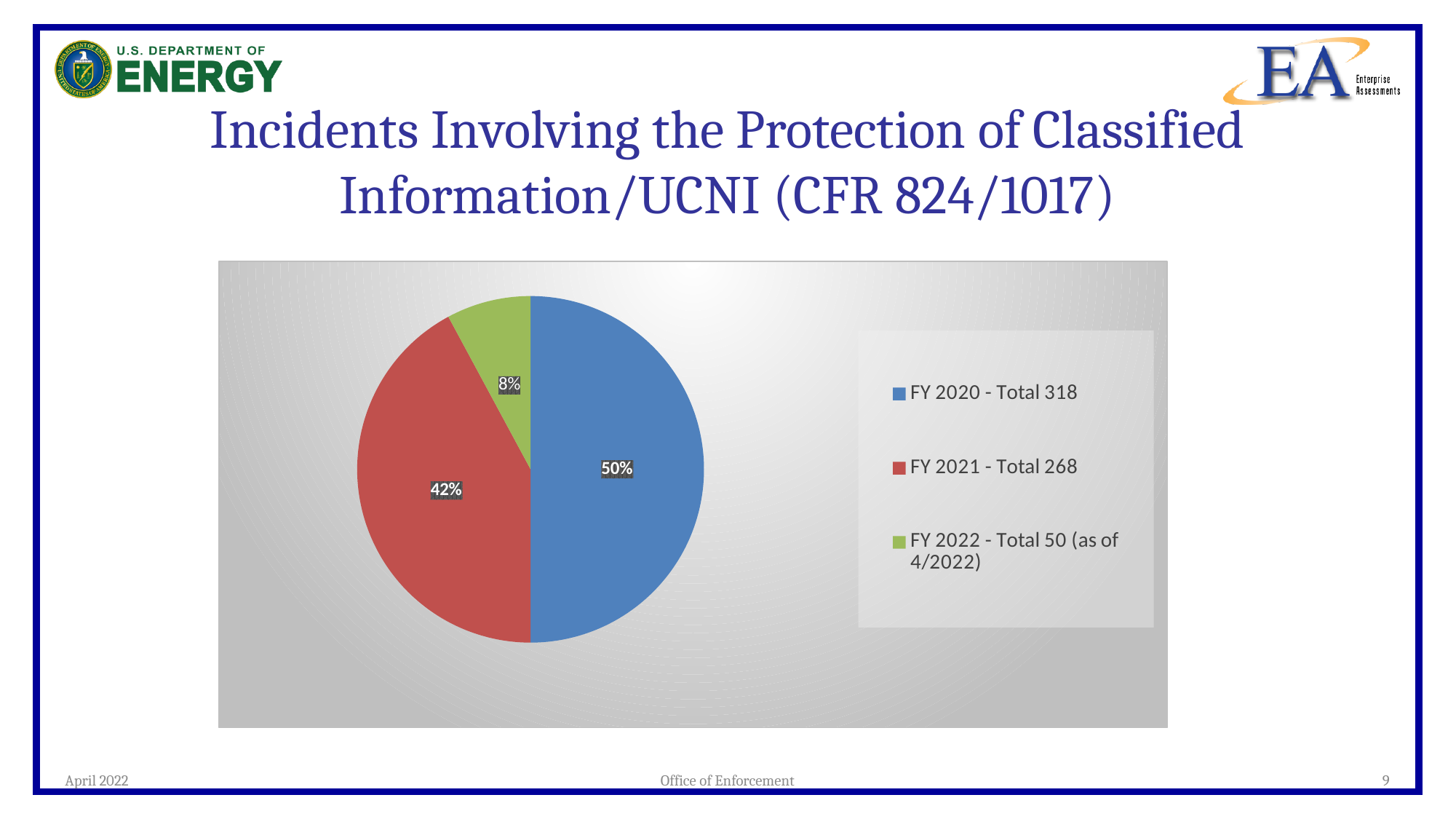
What kind of chart is shown on the slide? pie chart How many entries does the legend list? 3 How many slices does the pie chart have? 3 What share of the pie does FY 2022 represent? 8% Which fiscal year has the smallest slice of the pie? FY 2022 What is the total number of incidents for FY 2021 according to the legend? 268 What share of the pie does FY 2020 represent? 50% What is the total number of incidents for FY 2020 according to the legend? 318 Which fiscal year has the largest slice of the pie? FY 2020 What share of the pie does FY 2021 represent? 42% Which colour represents FY 2022 in the pie chart? green What is the difference in percentage points between the FY 2020 and FY 2021 slices? 8%